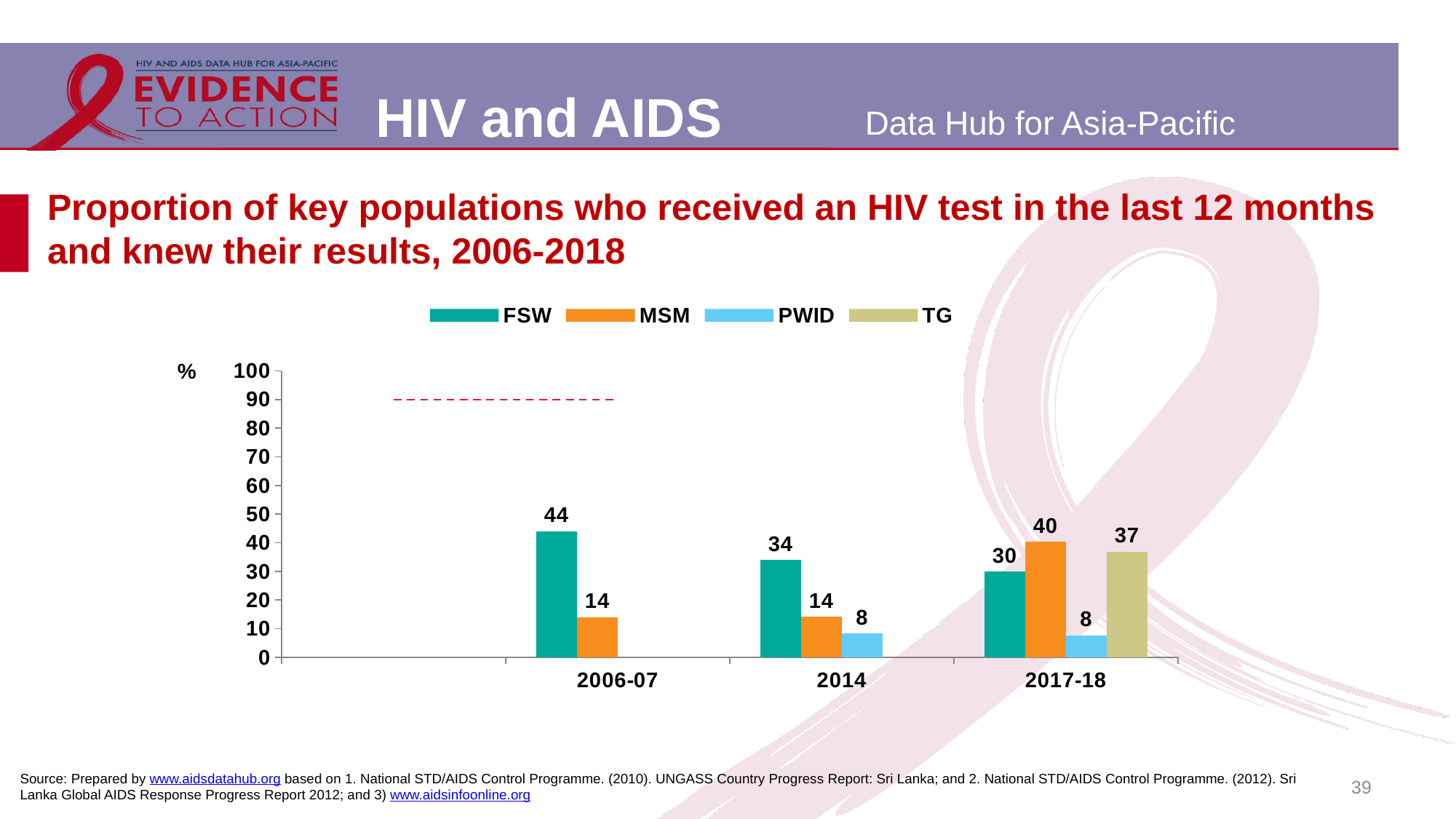
What is the value for PWID in 2014? 8 Which key population has the lowest value in 2014? PWID What is the value for TG in 2017-18? 37 What kind of chart is shown on the slide? Bar chart Do the FSW values rise or fall from 2006-07 to 2017-18? Fall Which key population has the highest value in 2017-18? MSM How many time periods are shown on the x axis? 3 Which is larger in 2014, the FSW value or the MSM value? FSW What is the difference between the FSW and MSM values in 2006-07? 30 What is the value for MSM in 2017-18? 40 What is the value for FSW in 2006-07? 44 How many series does the legend list? 4